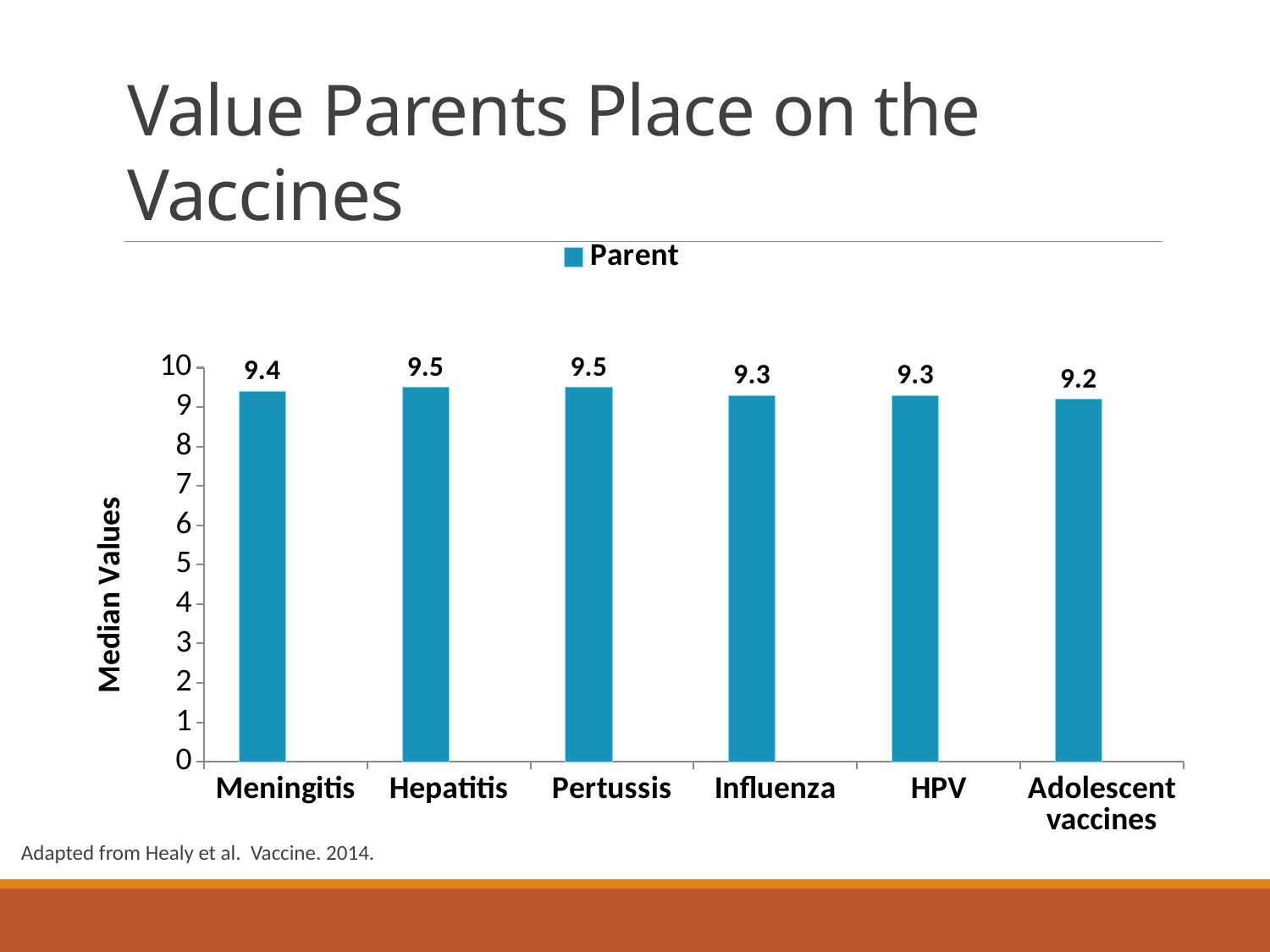
What is the difference between the median values for Hepatitis and Adolescent vaccines? 0.3 What kind of chart is shown on the slide? Bar chart How many vaccine categories are shown on the x axis? 6 What is the median value for HPV? 9.3 Which has a higher median value, Pertussis or Influenza? Pertussis What is the median value for Adolescent vaccines? 9.2 Which vaccine has the lowest median value? Adolescent vaccines What is the median value for Meningitis? 9.4 Which vaccines share the highest median value? Hepatitis and Pertussis How many series does the legend list? 1 What is the label of the y axis? Median Values What is the median value for Influenza? 9.3